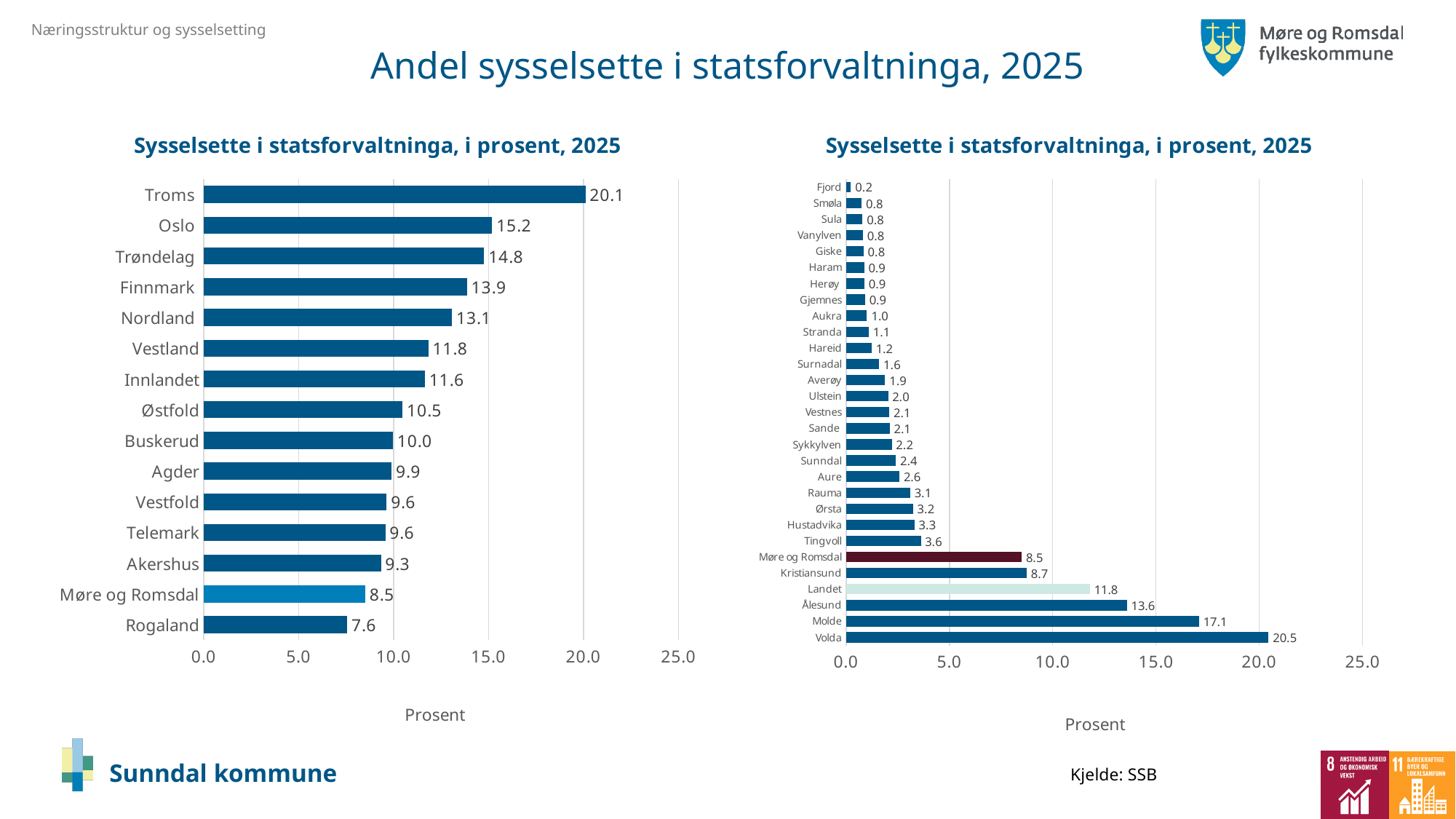
In the left chart, what is the difference between Oslo and Møre og Romsdal? 6.7 In the right chart, what is the value for Landet? 11.8 In the left chart, what is the value for Troms? 20.1 In the right chart, what is the value for Sunndal? 2.4 What kind of chart is the right chart? Bar chart In the left chart, which county has the lowest value? Rogaland In the left chart, which is larger, Finnmark or Nordland? Finnmark In the right chart, which municipality has the highest value? Volda What is the x-axis label of the left chart? Prosent In the right chart, what is the difference between Molde and Ålesund? 3.5 How many counties are shown in the left chart? 15 In the right chart, which is larger, Kristiansund or Møre og Romsdal? Kristiansund